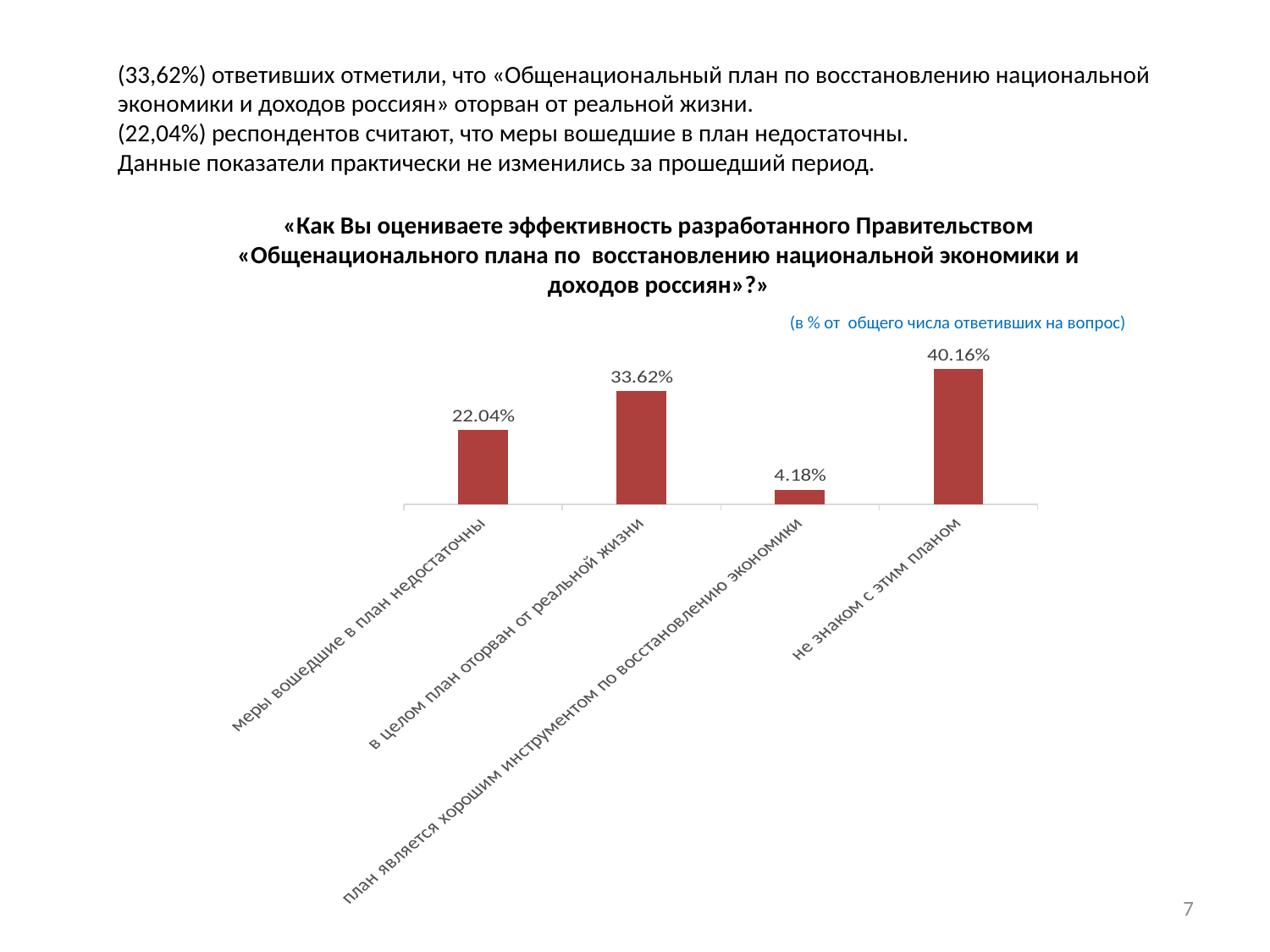
Which category has the highest value? не знаком с этим планом What is the difference between the values for «не знаком с этим планом» and «в целом план оторван от реальной жизни»? 6.54% What is the value for «в целом план оторван от реальной жизни»? 33.62% Which is larger: the value for «меры вошедшие в план недостаточны» or for «план является хорошим инструментом по восстановлению экономики»? меры вошедшие в план недостаточны What unit does the chart's subtitle say the values are expressed in? % от общего числа ответивших на вопрос What is the value for «план является хорошим инструментом по восстановлению экономики»? 4.18% What is the difference between the values for «в целом план оторван от реальной жизни» and «меры вошедшие в план недостаточны»? 11.58% Which category has the lowest value? план является хорошим инструментом по восстановлению экономики What is the value for «меры вошедшие в план недостаточны»? 22.04% How many categories are shown in the chart? 4 What is the value for «не знаком с этим планом»? 40.16% What kind of chart is shown on the slide? bar chart